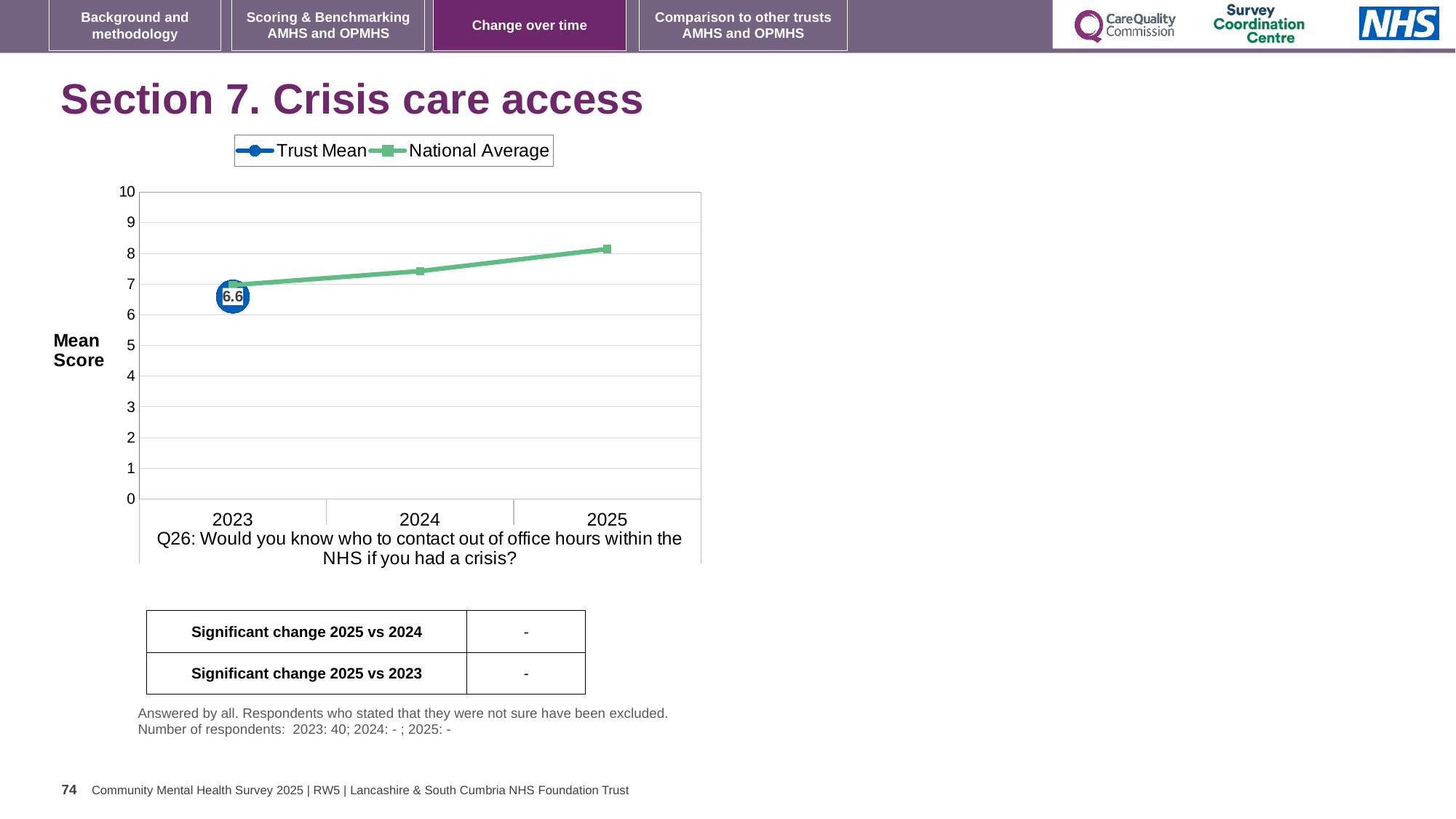
How many years are shown on the x axis? 3 In which year is the National Average highest? 2025 Does the National Average rise or fall from 2023 to 2025? rise Is the National Average for 2023 greater or less than 8? less What kind of chart is shown on the slide? line chart What is the Trust Mean value for 2023? 6.6 In which year is the National Average lowest? 2023 Is the National Average for 2024 greater or less than 7? greater What are the two series named in the legend? Trust Mean and National Average How many series does the legend list? 2 What is the label on the y axis? Mean Score In 2023, which is higher: the Trust Mean or the National Average? National Average